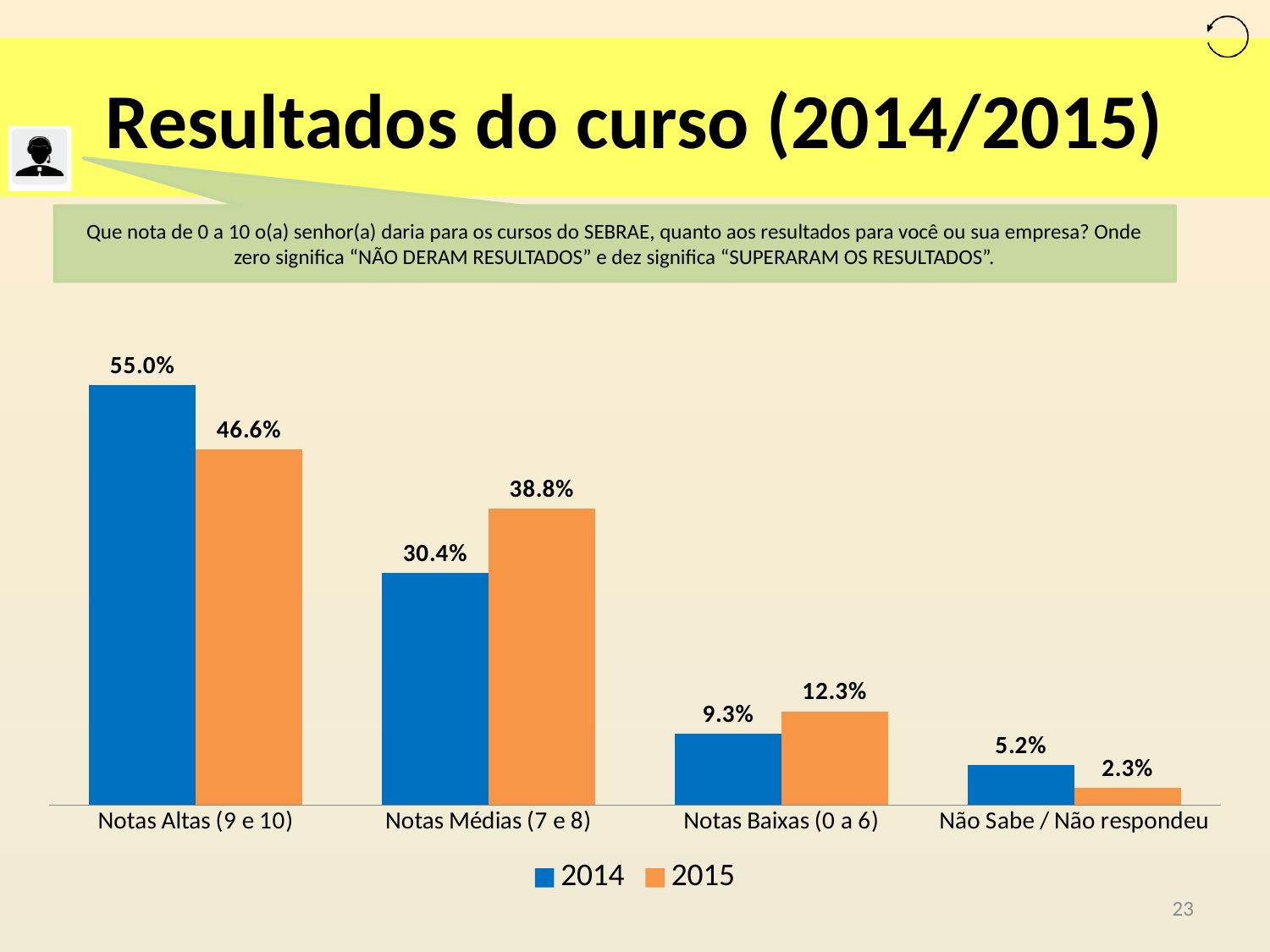
Which colour represents the 2015 series in the legend? Orange Which category has the highest value for 2014? Notas Altas (9 e 10) Which is larger for Notas Médias (7 e 8): the 2014 value or the 2015 value? 2015 How many series does the legend list? 2 What is the difference between the 2014 and 2015 values for Notas Altas (9 e 10)? 8.4% How many categories are shown on the x axis? 4 What is the value for 2015 in the Não Sabe / Não respondeu category? 2.3% Which category has the lowest value for 2015? Não Sabe / Não respondeu What is the value for 2014 in the Notas Altas (9 e 10) category? 55.0% What is the value for 2015 in the Notas Médias (7 e 8) category? 38.8% What kind of chart is shown on the slide? Bar chart What is the difference between the 2015 and 2014 values for Notas Baixas (0 a 6)? 3.0%